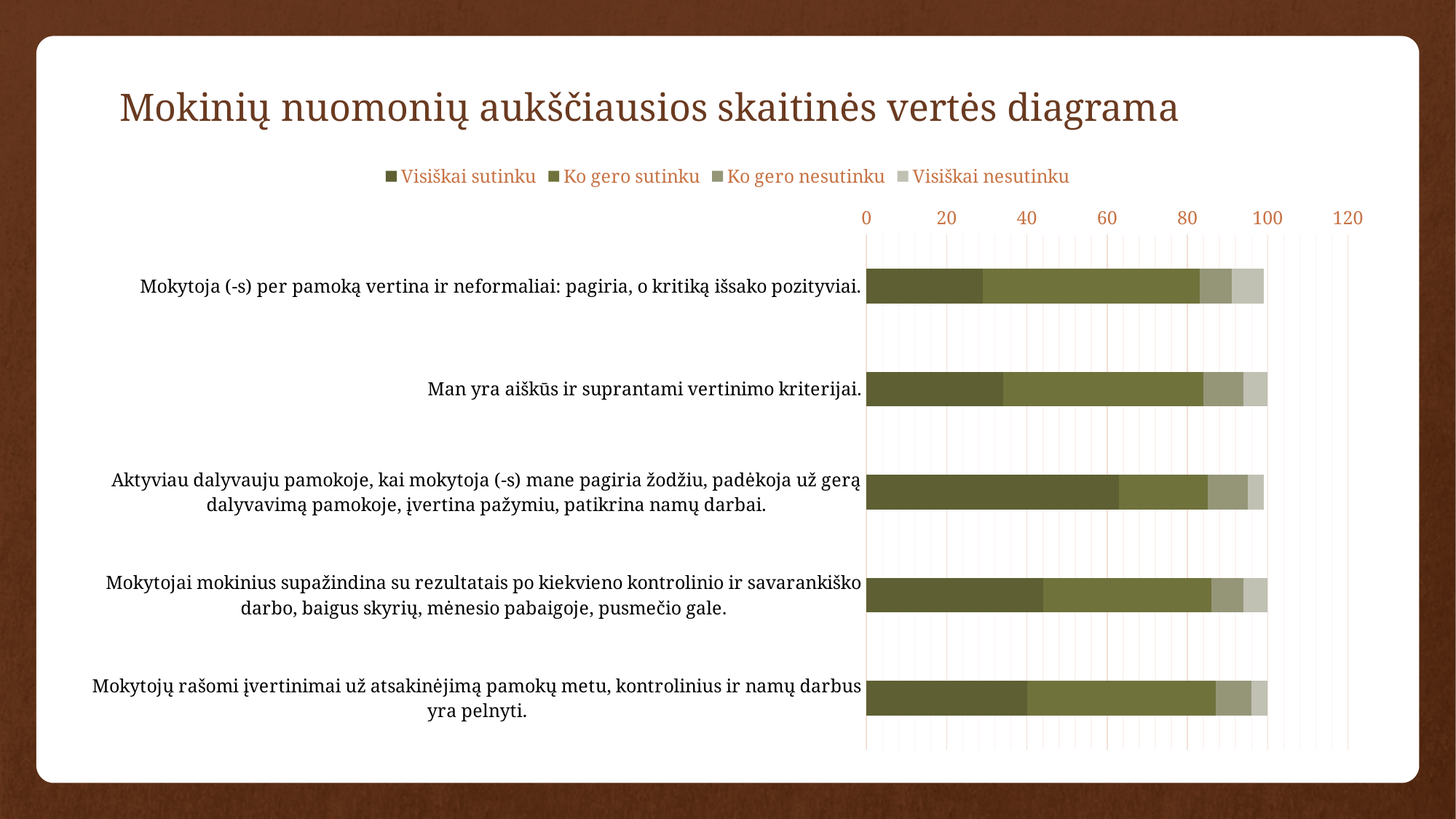
What kind of chart is shown on the slide? Stacked bar chart Which has the larger 'Visiškai sutinku' segment: 'Aktyviau dalyvauju pamokoje...' or 'Mokytoja (-s) per pamoką vertina ir neformaliai...'? Aktyviau dalyvauju pamokoje... Is the 'Visiškai sutinku' value for 'Mokytoja (-s) per pamoką vertina ir neformaliai...' greater or less than 40? less Which statement has the largest 'Visiškai sutinku' segment? Aktyviau dalyvauju pamokoje, kai mokytoja (-s) mane pagiria žodžiu, padėkoja už gerą dalyvavimą pamokoje, įvertina pažymiu, patikrina namų darbai. Is the 'Visiškai sutinku' value for 'Mokytojai mokinius supažindina su rezultatais...' greater or less than 40? greater How many series does the legend list? 4 What is the title of the chart? Mokinių nuomonių aukščiausios skaitinės vertės diagrama Which series is listed first in the legend? Visiškai sutinku Is the 'Visiškai sutinku' value for 'Man yra aiškūs ir suprantami vertinimo kriterijai.' greater or less than 40? less How many categories (statements) are plotted on the chart? 5